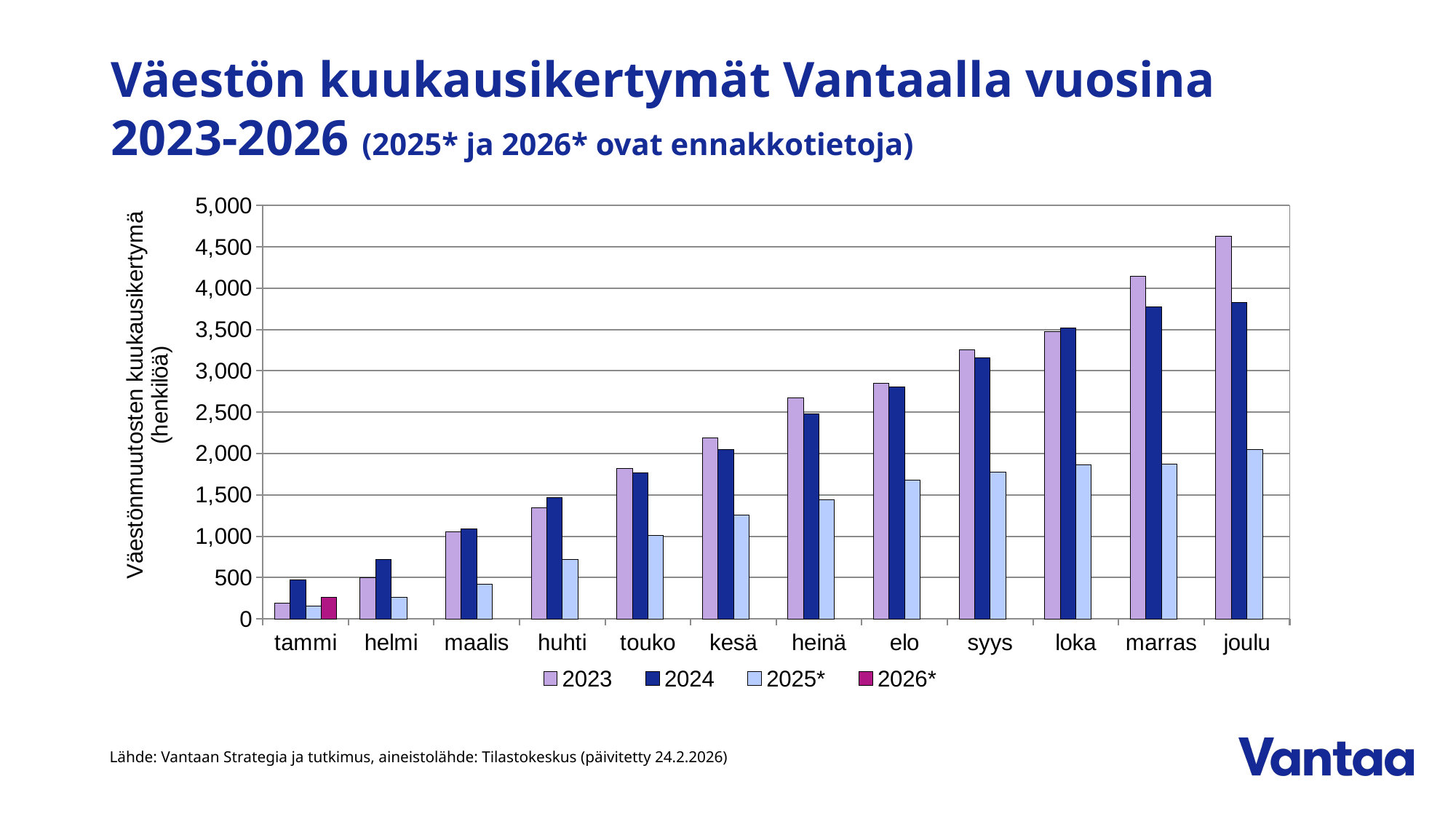
How many months are shown on the x axis? 12 In which month is the 2023 value highest? joulu For tammi, which series has the larger value, 2023 or 2024? 2024 Do the 2025* values rise or fall from tammi to joulu? rise For marras, which series has the larger value, 2023 or 2024? 2023 Is the 2023 value for joulu greater or less than 4,000? greater Is the 2025* value for joulu greater or less than 1,500? greater In which month is the 2023 value lowest? tammi Is the 2024 value for marras greater or less than 4,000? less How many series does the legend list? 4 What kind of chart is shown on the slide? bar chart